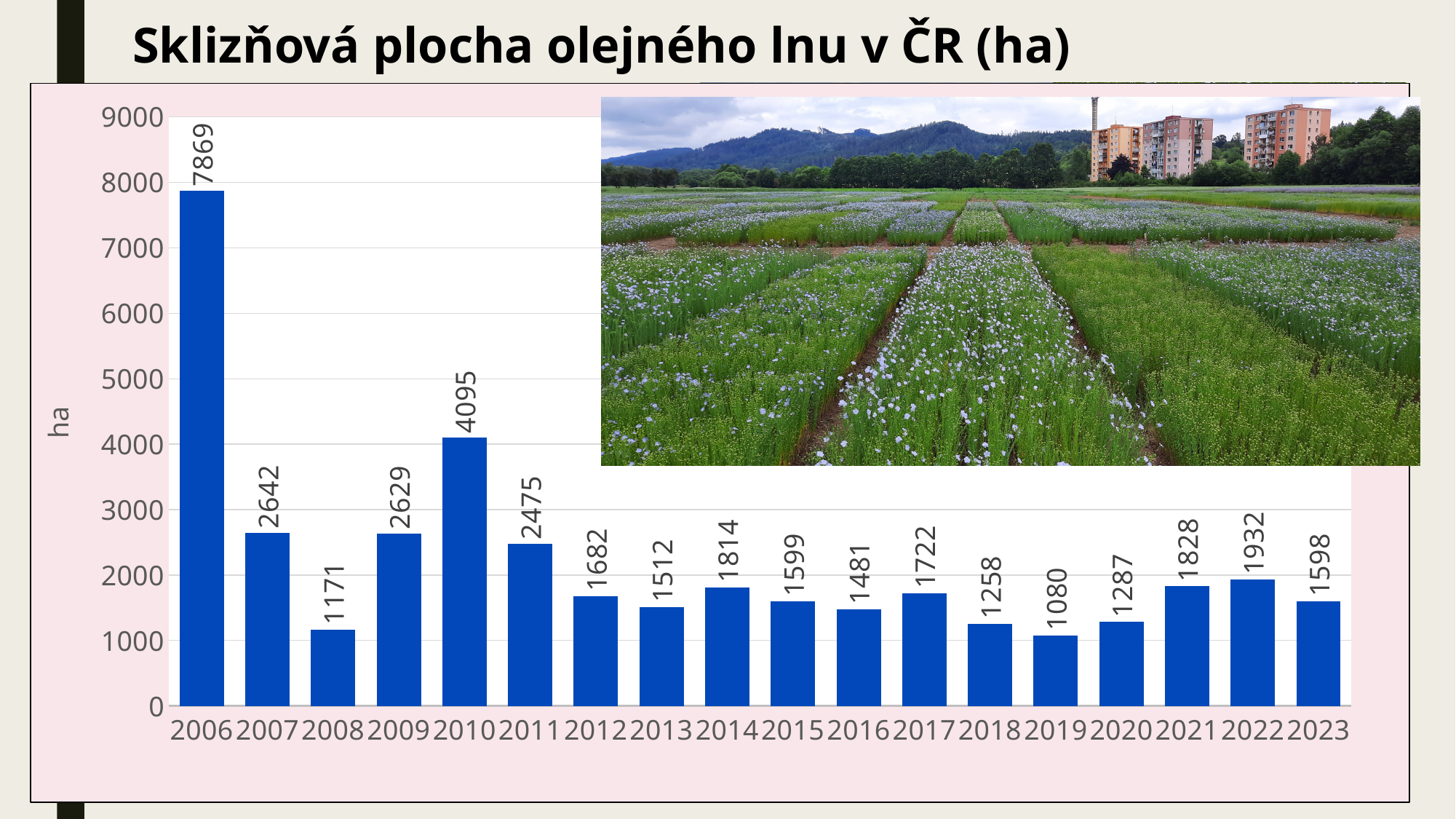
How many years are shown on the x axis? 18 What was the harvested area of oil flax in 2006? 7869 Which year has the lowest harvested area? 2019 Which year has the highest harvested area? 2006 What type of chart is shown on the slide? bar chart What is the difference between the values for 2022 and 2023? 334 What value is shown for 2022? 1932 Which year has a larger value, 2007 or 2009? 2007 What value is shown for 2019? 1080 What is the label of the vertical axis? ha What is the difference between the values for 2006 and 2010? 3774 Is the value for 2014 greater or less than 2000? less